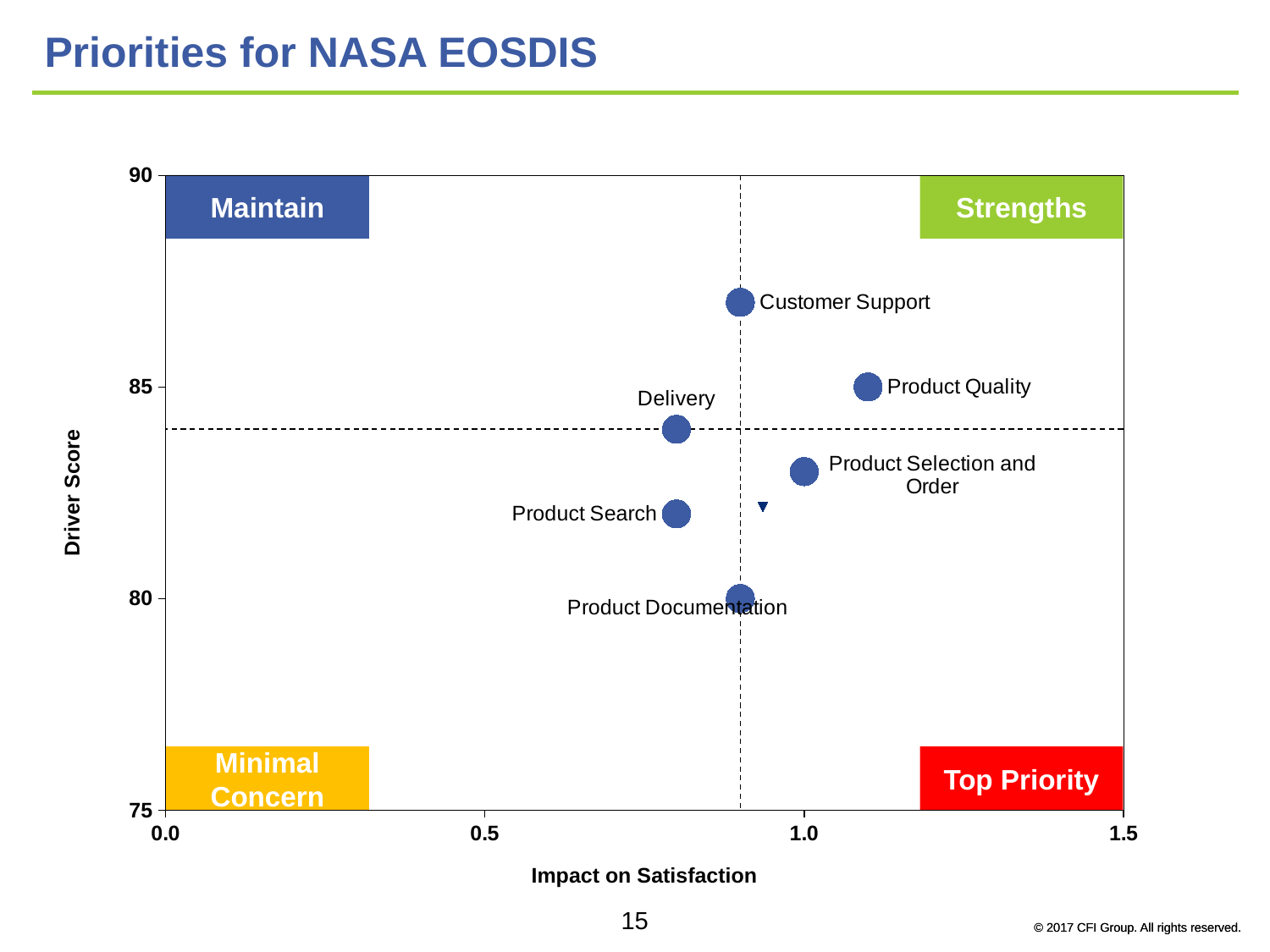
Which has a higher Driver Score, Customer Support or Product Documentation? Customer Support Which driver has the highest Impact on Satisfaction? Product Quality Is the Impact on Satisfaction for Delivery greater or less than 1.0? less Is the Impact on Satisfaction for Product Quality greater or less than 1.0? greater What label is shown in the top-right quadrant of the chart? Strengths How many labeled data points are plotted on the chart? 6 Which driver has the highest Driver Score? Customer Support What kind of chart is shown on the slide? scatter chart Is the Driver Score for Customer Support greater or less than 85? greater Which driver has the lowest Driver Score? Product Documentation What is the title of the horizontal axis? Impact on Satisfaction